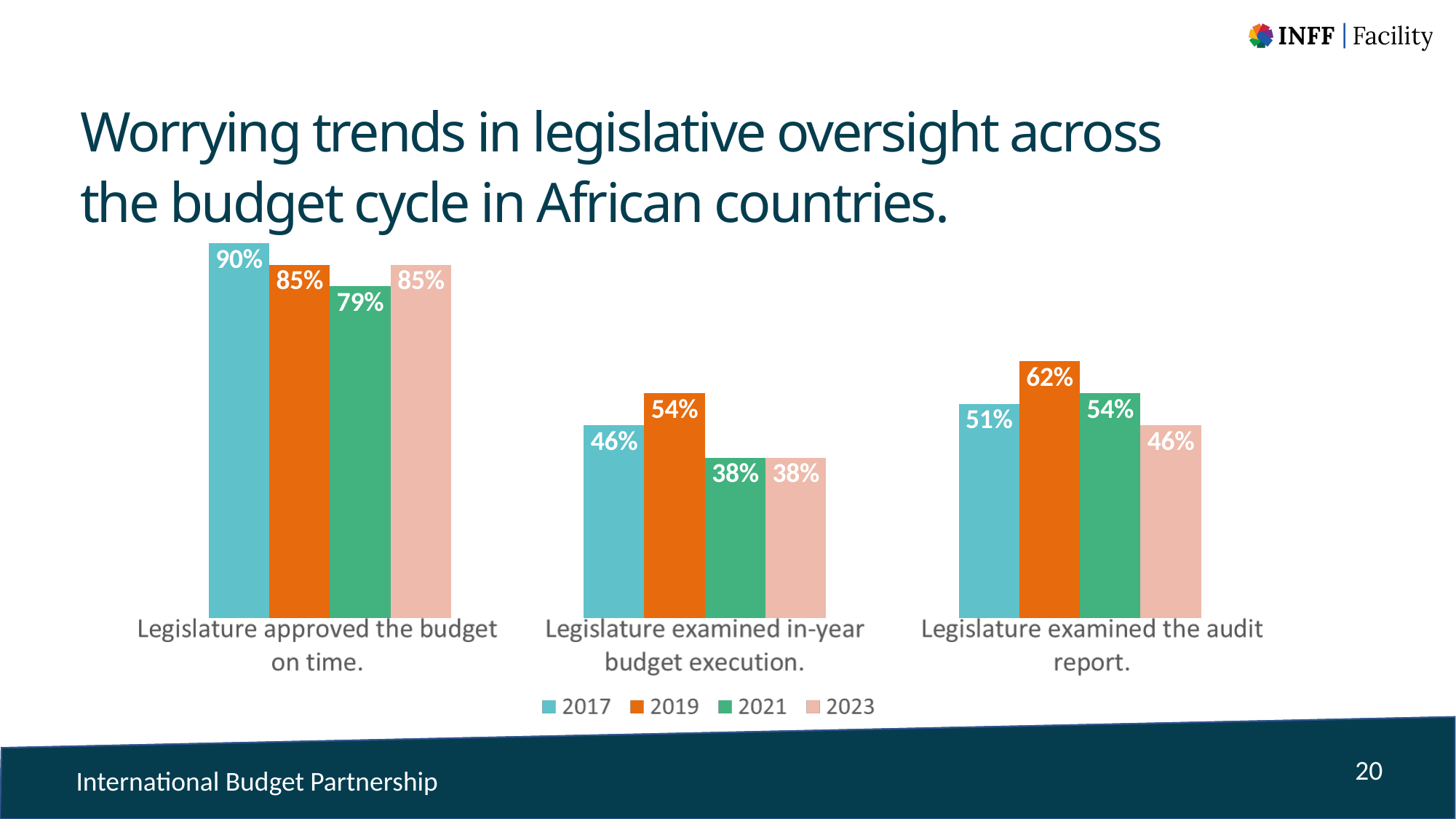
What is the 2021 value for 'Legislature approved the budget on time'? 79% Which year has the highest value for 'Legislature examined in-year budget execution'? 2019 What is the 2019 value for 'Legislature examined the audit report'? 62% What percentage of legislatures approved the budget on time in 2017? 90% How many categories are shown on the x axis? 3 What kind of chart is shown on the slide? Bar chart Which year is represented by the orange bars? 2019 Which year has the lowest value for 'Legislature examined the audit report'? 2023 What is the 2023 value for 'Legislature examined in-year budget execution'? 38% How many series does the legend list? 4 What is the difference between the 2019 and 2023 values for 'Legislature examined the audit report'? 16% Which is larger: the 2017 value for 'Legislature examined in-year budget execution' or the 2017 value for 'Legislature examined the audit report'? Legislature examined the audit report